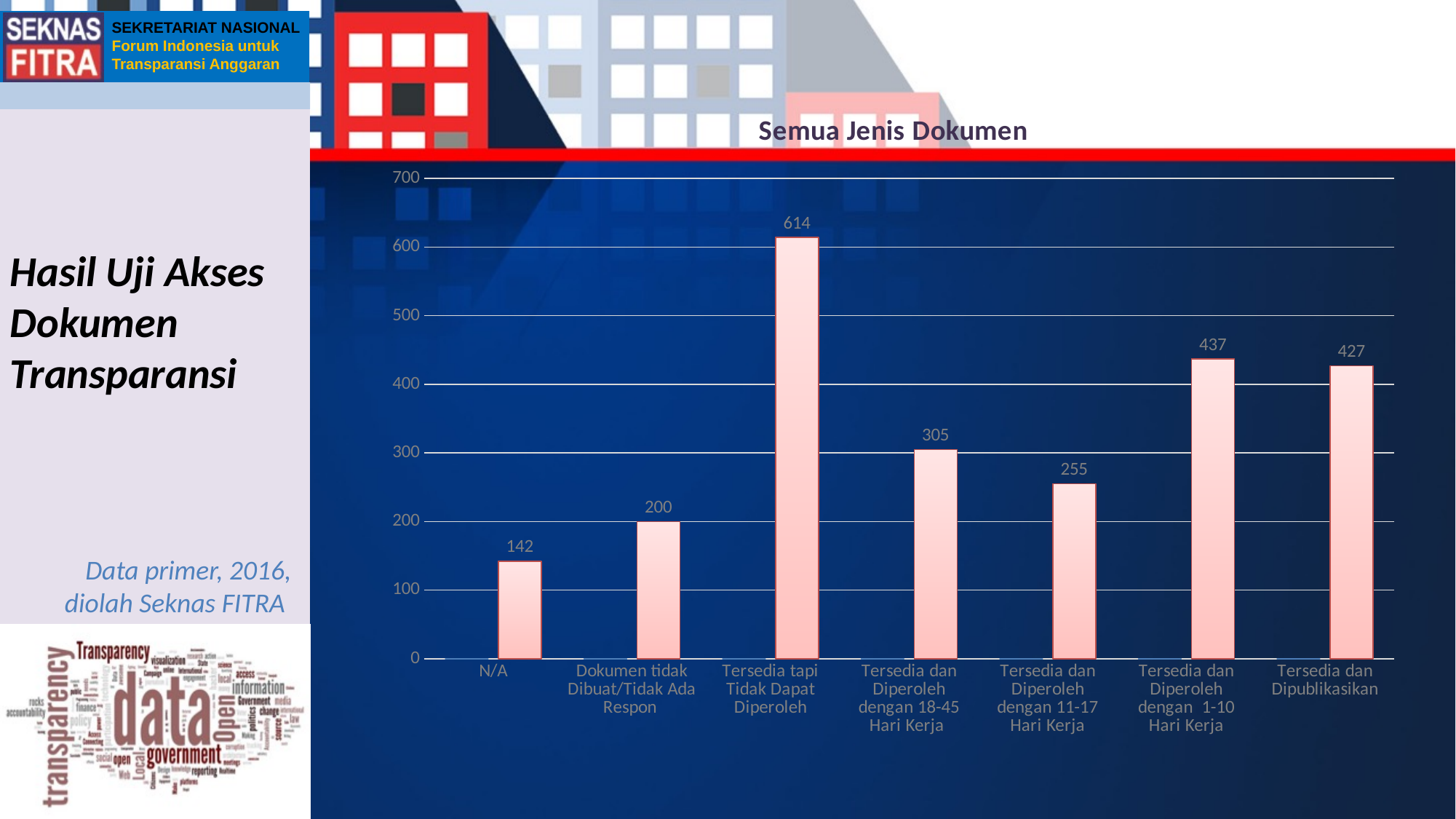
What is the title of the chart? Semua Jenis Dokumen Is the value for "Tersedia dan Diperoleh dengan 1-10 Hari Kerja" greater or less than 400? greater What kind of chart is shown on the slide? bar chart How many categories are shown on the x axis? 7 Which is larger: the value for "Dokumen tidak Dibuat/Tidak Ada Respon" or the value for "Tersedia dan Diperoleh dengan 11-17 Hari Kerja"? Tersedia dan Diperoleh dengan 11-17 Hari Kerja What is the value for "Tersedia dan Dipublikasikan"? 427 What is the value for "N/A"? 142 Which category has the highest value? Tersedia tapi Tidak Dapat Diperoleh What is the value for "Tersedia dan Diperoleh dengan 11-17 Hari Kerja"? 255 Which category has the lowest value? N/A What is the value for "Tersedia tapi Tidak Dapat Diperoleh"? 614 What is the difference between the values for "Tersedia tapi Tidak Dapat Diperoleh" and "Tersedia dan Diperoleh dengan 18-45 Hari Kerja"? 309